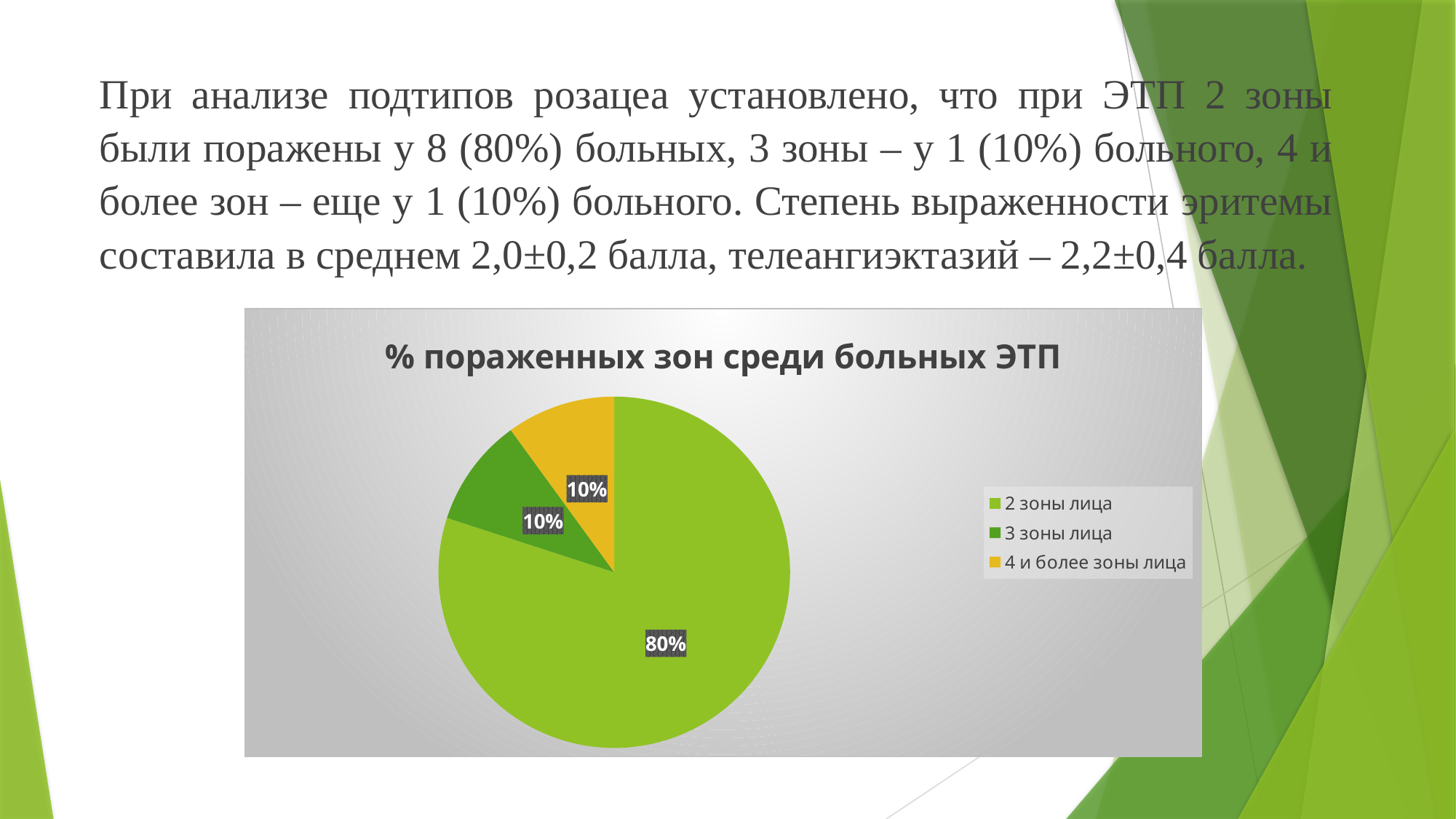
Which is larger: the share for "2 зоны лица" or the share for "4 и более зоны лица"? 2 зоны лица Is the share for "2 зоны лица" greater or less than 50%? greater Which legend entry is shown in yellow? 4 и более зоны лица What is the difference between the share for "2 зоны лица" and the share for "3 зоны лица"? 70% What is the title of the chart? % пораженных зон среди больных ЭТП What share of the pie does "3 зоны лица" take? 10% What share of the pie does "2 зоны лица" take? 80% How many entries does the legend list? 3 Which category has the largest slice of the pie? 2 зоны лица How many slices does the pie chart have? 3 What type of chart is shown on the slide? pie chart What share of the pie does "4 и более зоны лица" take? 10%